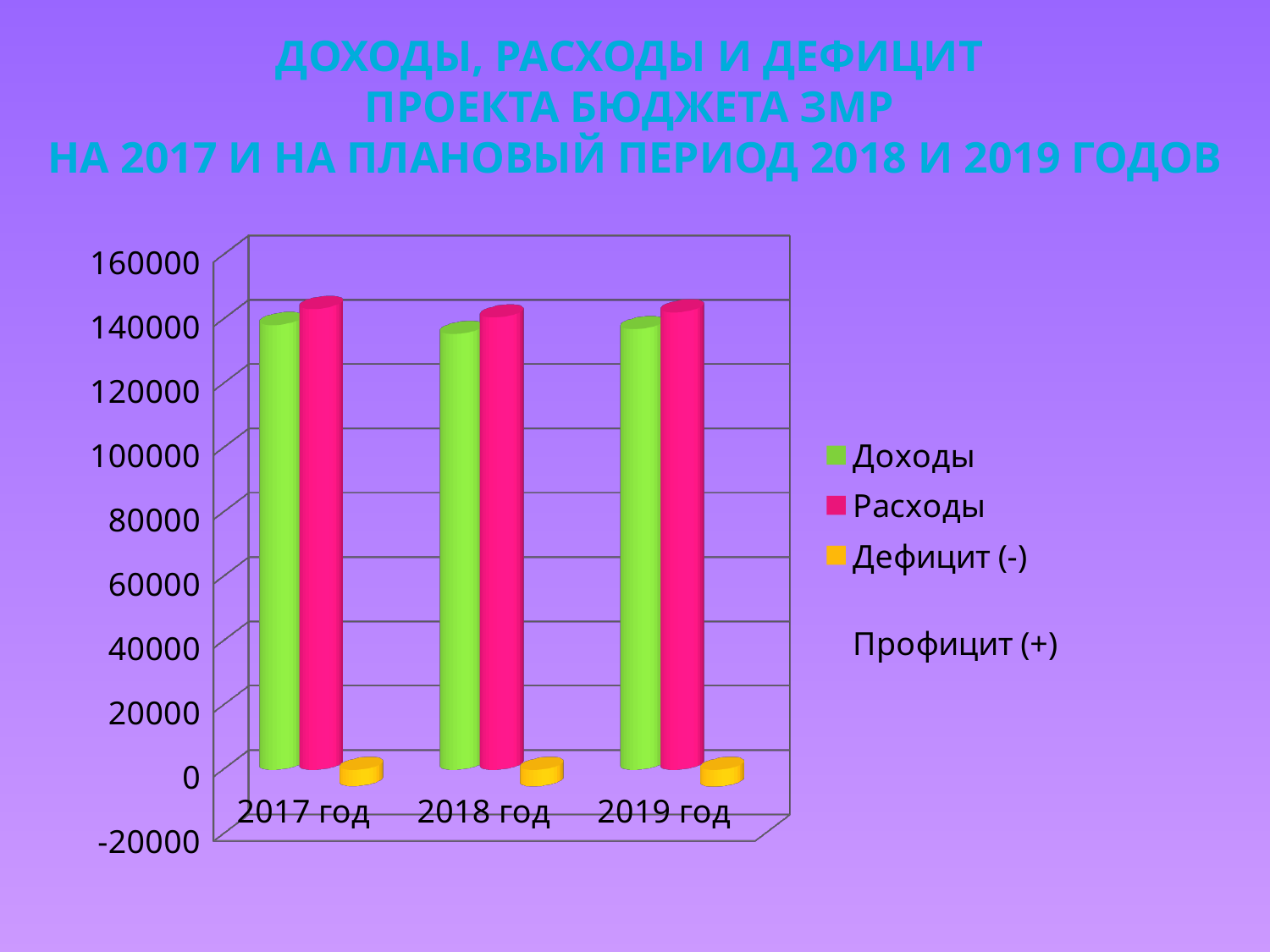
Which series is shown in yellow in the chart legend? Дефицит (-) Is the value for Расходы in 2018 год greater or less than 120000? greater Which series has the lowest value in 2018 год? Дефицит (-) What kind of chart is shown on the slide? bar chart In 2017 год, which is larger: Доходы or Расходы? Расходы Is the value for Дефицит (-) in 2019 год greater or less than 20000? less Which series is shown in green in the chart legend? Доходы How many series with colour swatches does the chart legend list? 3 In 2018 год, which is larger: Доходы or Расходы? Расходы Which series has the highest value in 2019 год? Расходы How many year categories are shown on the x axis of the chart? 3 Is the value for Доходы in 2017 год greater or less than 120000? greater